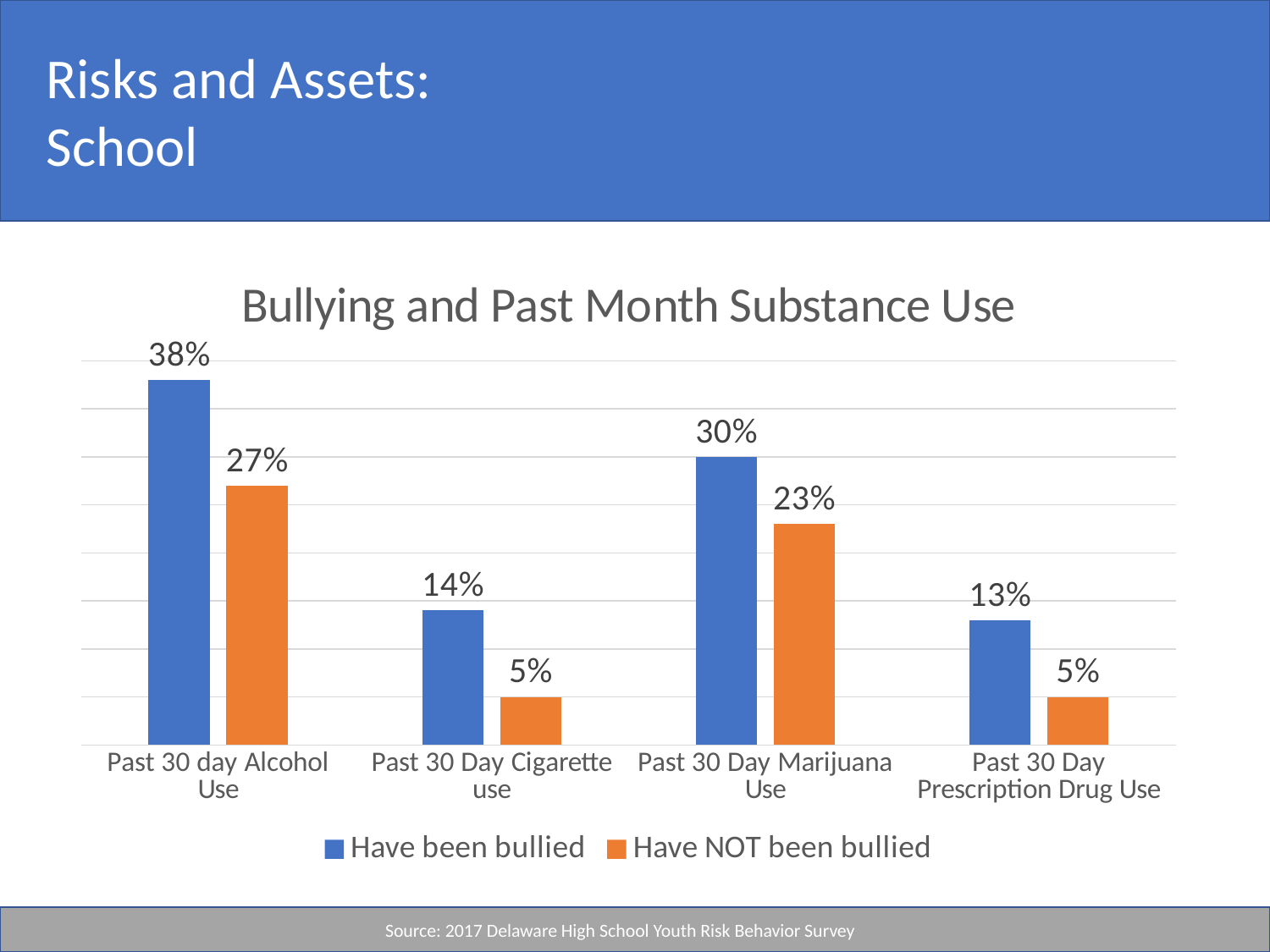
What is the value for 'Have NOT been bullied' for Past 30 Day Marijuana Use? 23% What is the difference between 'Have been bullied' and 'Have NOT been bullied' for Past 30 day Alcohol Use? 11% What is the value for 'Have been bullied' for Past 30 day Alcohol Use? 38% Which category has the lowest value for 'Have been bullied'? Past 30 Day Prescription Drug Use Which category has the highest value for 'Have been bullied'? Past 30 day Alcohol Use What is the difference between 'Have been bullied' and 'Have NOT been bullied' for Past 30 Day Cigarette use? 9% How many series does the legend list? 2 Which is larger: 'Have been bullied' for Past 30 Day Marijuana Use or 'Have NOT been bullied' for Past 30 Day Marijuana Use? Have been bullied What is the value for 'Have NOT been bullied' for Past 30 Day Cigarette use? 5% What is the title of the chart? Bullying and Past Month Substance Use What kind of chart is shown on the slide? Bar chart How many categories are shown on the x axis? 4